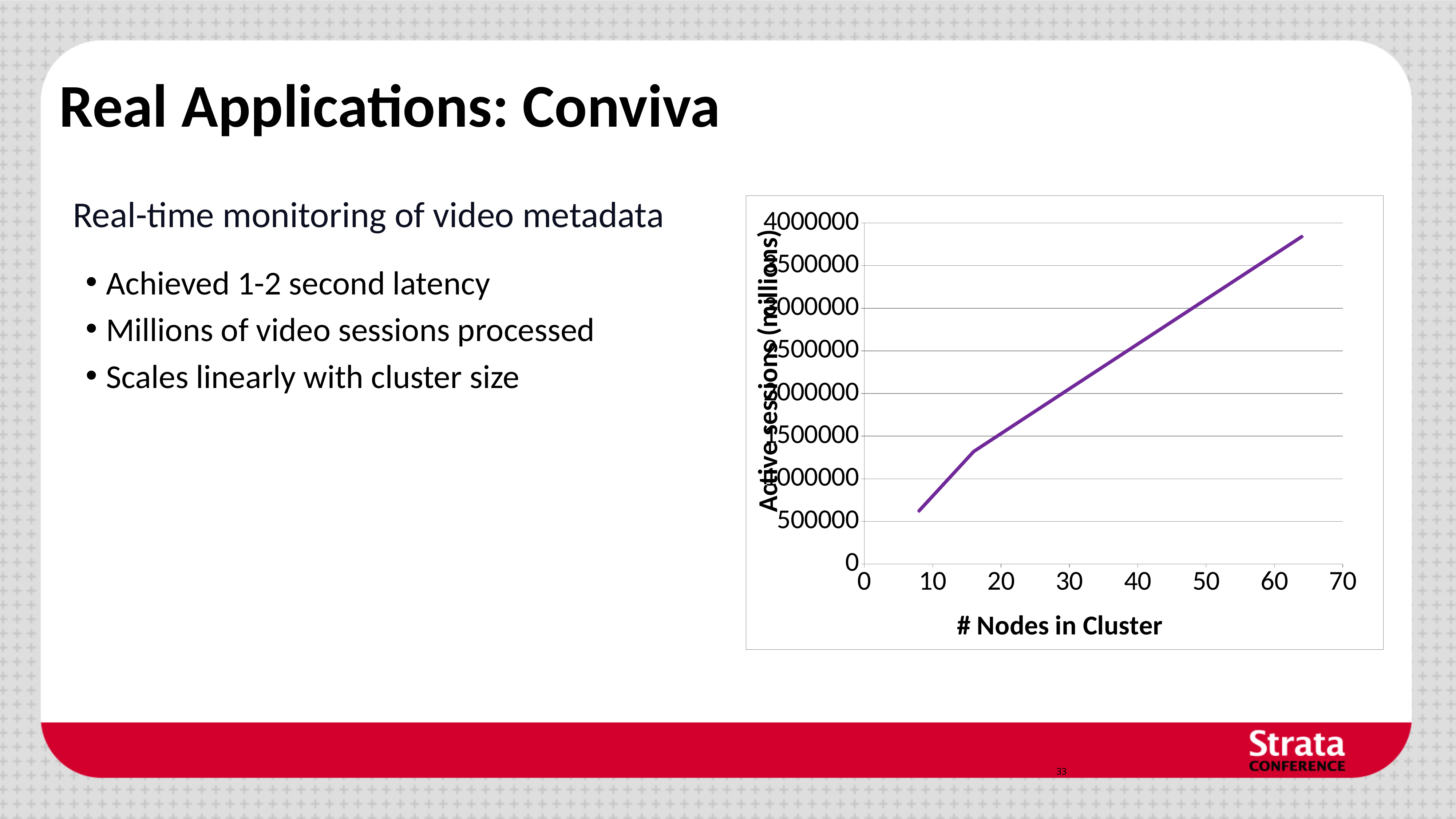
Is the value for active sessions at 16 nodes greater or less than 1500000? less Is the value for active sessions at 16 nodes greater or less than 1000000? greater Do active sessions rise or fall as the number of nodes in the cluster increases? rise What kind of chart is shown on the slide? line chart What is the label of the x axis of the chart? # Nodes in Cluster What is the label of the y axis of the chart? Active sessions (millions) Is the value for active sessions at 8 nodes greater or less than 1000000? less What is the highest value shown on the y axis of the chart? 4000000 Which is larger: active sessions at 16 nodes or at 64 nodes? 64 nodes